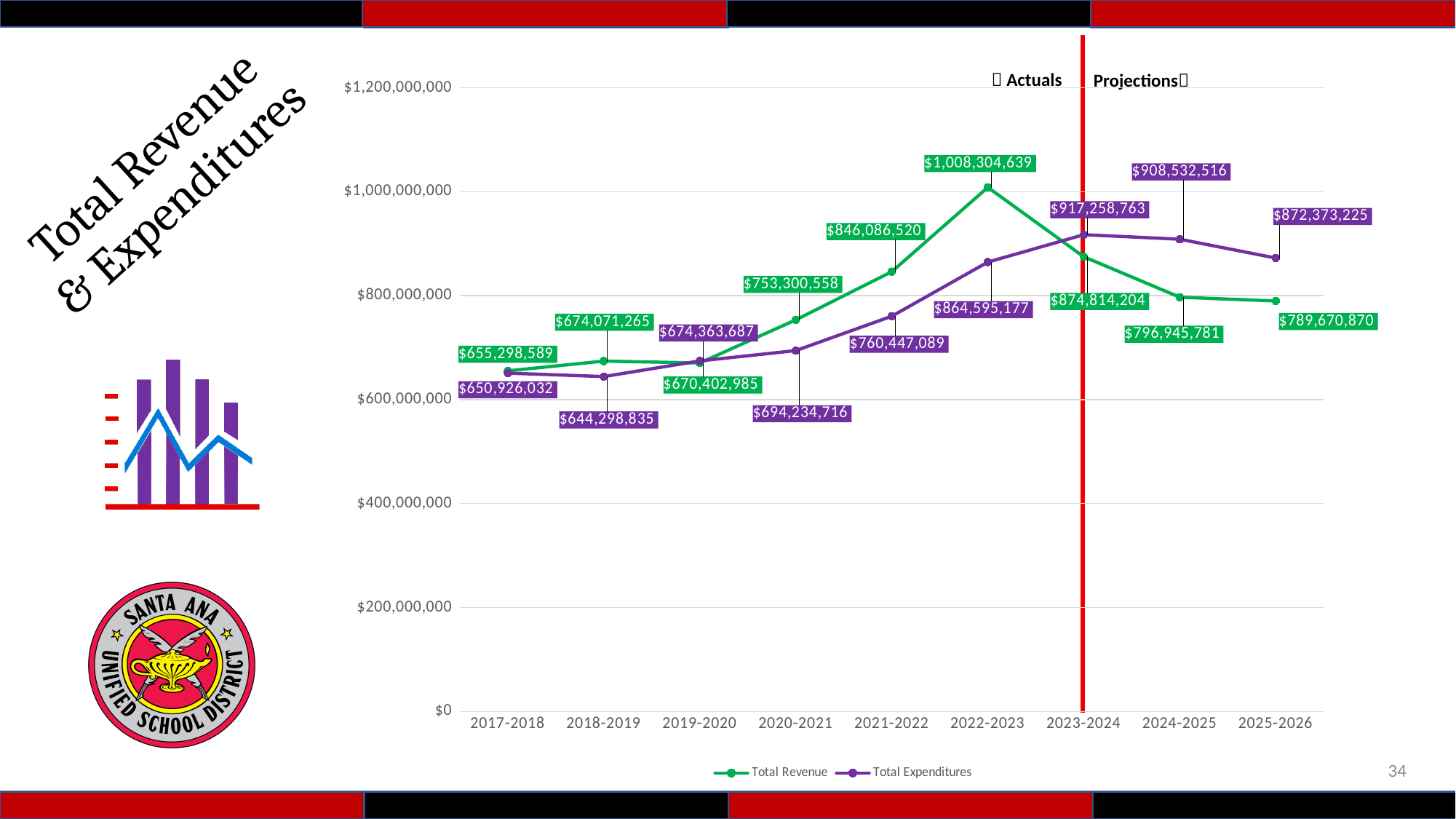
What is the Total Expenditures value for 2023-2024? $917,258,763 What is the Total Revenue for 2017-2018? $655,298,589 How many series does the legend list? 2 Does Total Expenditures rise or fall from 2017-2018 to 2023-2024? Rise What is the Total Revenue for 2022-2023? $1,008,304,639 What is the Total Expenditures value for 2025-2026? $872,373,225 What is the difference between Total Revenue and Total Expenditures in 2022-2023? $143,709,462 In 2025-2026, which is larger: Total Revenue or Total Expenditures? Total Expenditures In which year is Total Expenditures lowest? 2018-2019 In which year is Total Revenue highest? 2022-2023 What kind of chart is shown on the slide? Line chart How many years are shown on the x axis? 9